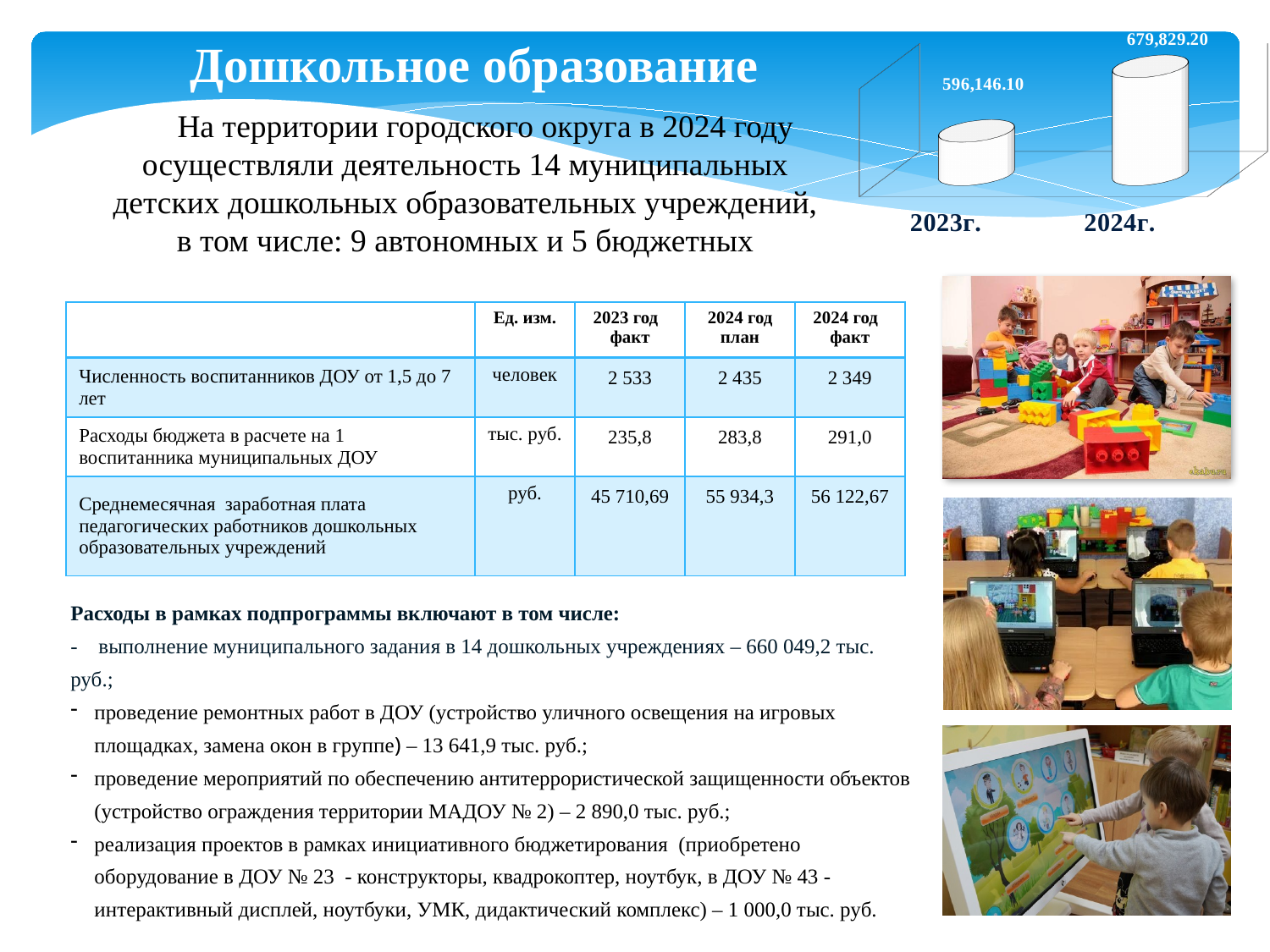
In the chart at the top right of the slide, which year has the lowest value? 2023г. How many categories are shown in the chart at the top right of the slide? 2 In the chart at the top right of the slide, what is the difference between the values for 2024г. and 2023г.? 83,683.10 In the chart at the top right of the slide, is the value for 2024г. larger or smaller than the value for 2023г.? larger In the chart at the top right of the slide, what is the value for 2024г.? 679,829.20 In the chart at the top right of the slide, do the values rise or fall from 2023г. to 2024г.? rise In the chart at the top right of the slide, which year has the highest value? 2024г. What kind of chart is shown at the top right of the slide? bar chart Are the bars in the chart at the top right of the slide drawn as cylinders or as flat rectangles? cylinders What are the category labels on the x axis of the chart at the top right of the slide? 2023г. and 2024г. In the chart at the top right of the slide, what is the value for 2023г.? 596,146.10